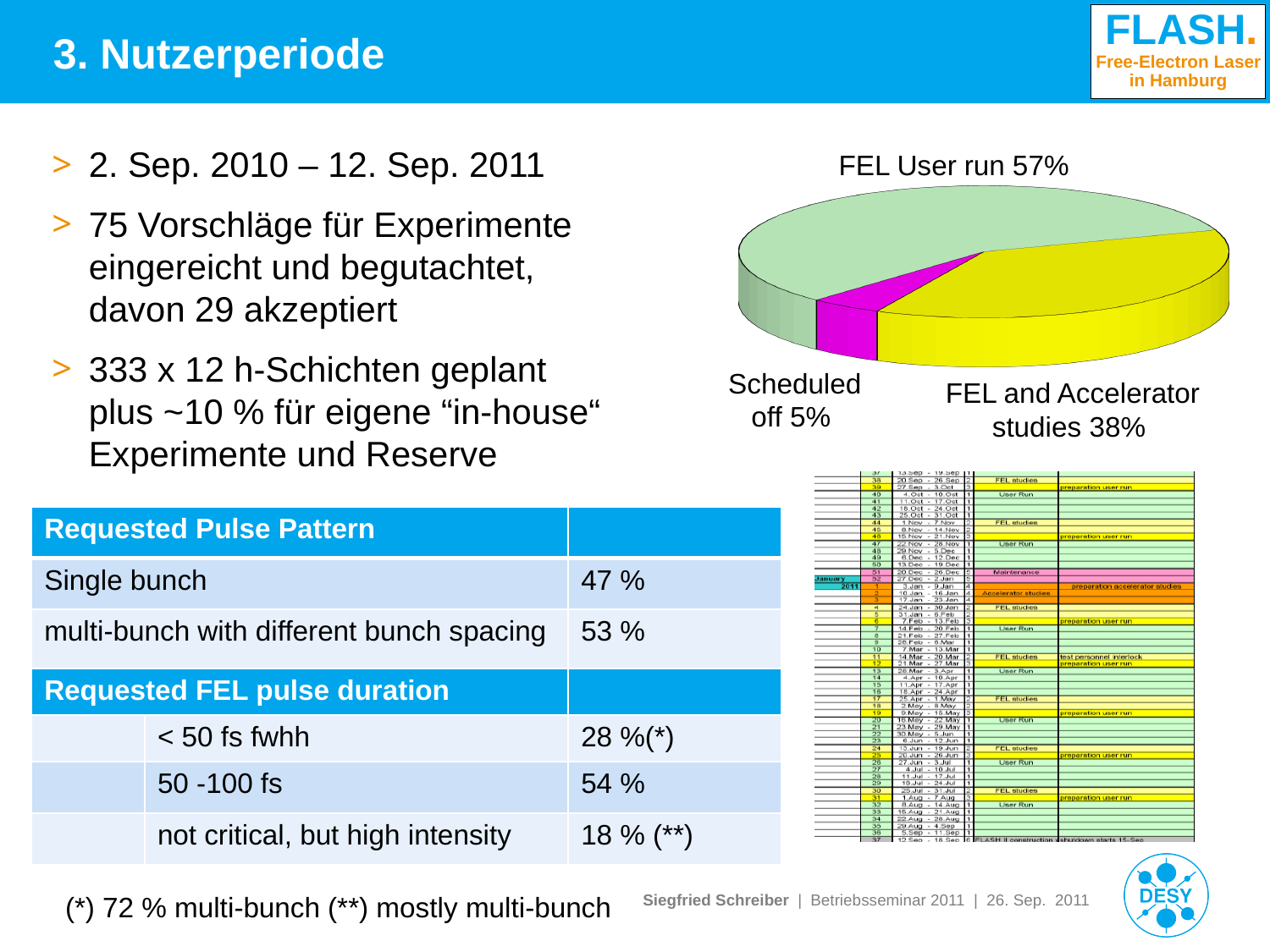
What colour is the FEL User run slice in the pie chart? Green What percentage does the pie chart show for FEL and Accelerator studies? 38% What do the three percentages in the pie chart add up to? 100% In the pie chart, what is the difference between FEL and Accelerator studies and Scheduled off? 33% What share of the pie chart is labelled Scheduled off? 5% Which category has the smallest slice in the pie chart? Scheduled off How many slices does the pie chart have? 3 What percentage does the pie chart show for FEL User run? 57% What kind of chart is shown in the upper right of the slide? Pie chart In the pie chart, how many percentage points larger is FEL User run than FEL and Accelerator studies? 19% Which category has the largest slice in the pie chart? FEL User run In the pie chart, which is larger: FEL and Accelerator studies or Scheduled off? FEL and Accelerator studies